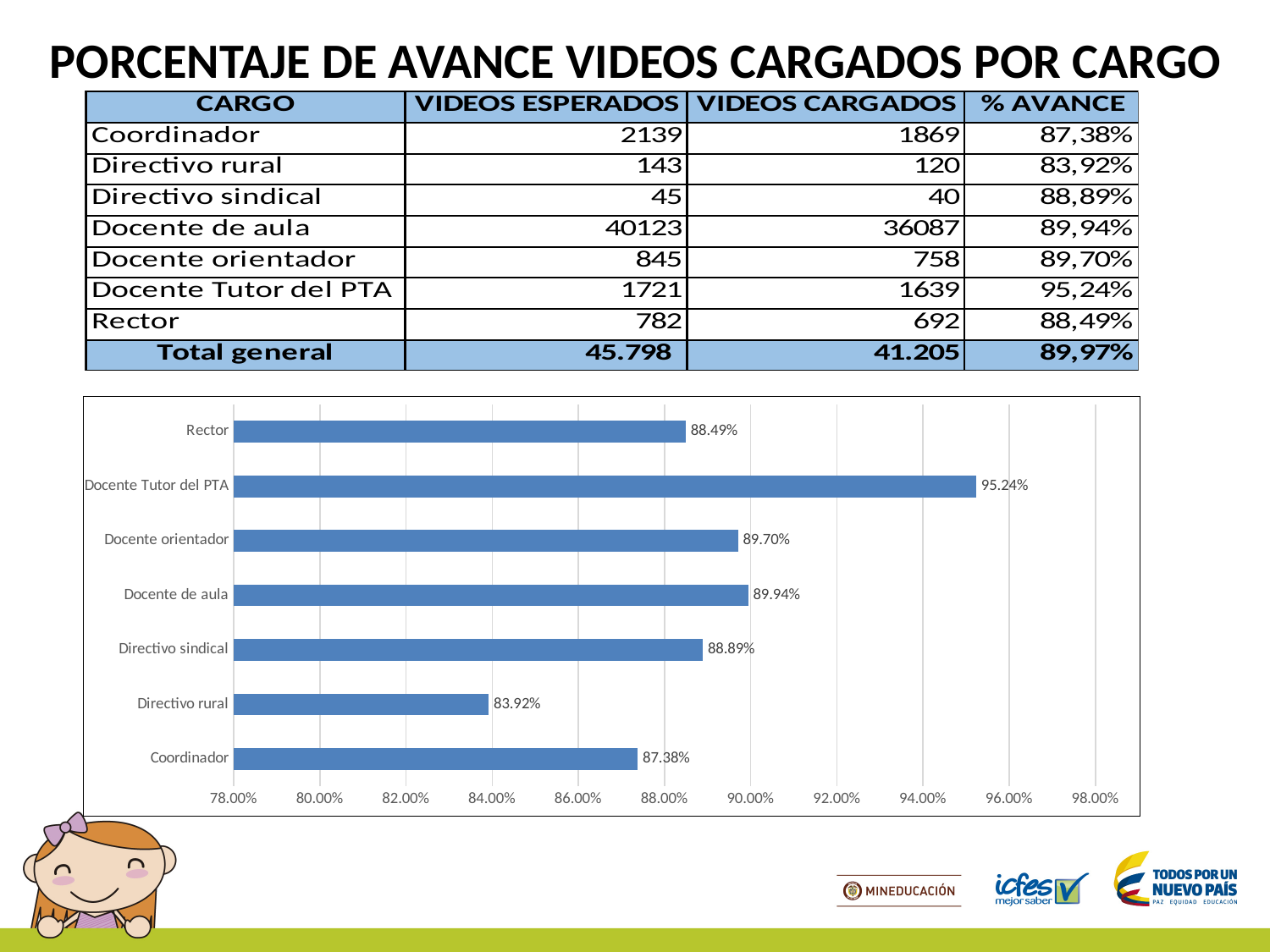
What kind of chart is shown on the slide? bar chart In the bar chart, what is the value for Docente Tutor del PTA? 95.24% In the bar chart, is the value for Docente de aula greater or less than 90.00%? less How many categories (cargos) are plotted in the bar chart? 7 In the bar chart, what is the value for Directivo rural? 83.92% Which category has the highest value in the bar chart? Docente Tutor del PTA In the bar chart, what is the value for Docente orientador? 89.70% Which category has the lowest value in the bar chart? Directivo rural In the bar chart, which is larger: the value for Rector or the value for Directivo sindical? Directivo sindical In the bar chart, what is the difference between the values for Docente Tutor del PTA and Directivo rural? 11.32% What is the lowest value shown on the horizontal axis of the bar chart? 78.00% In the bar chart, what is the value for Coordinador? 87.38%